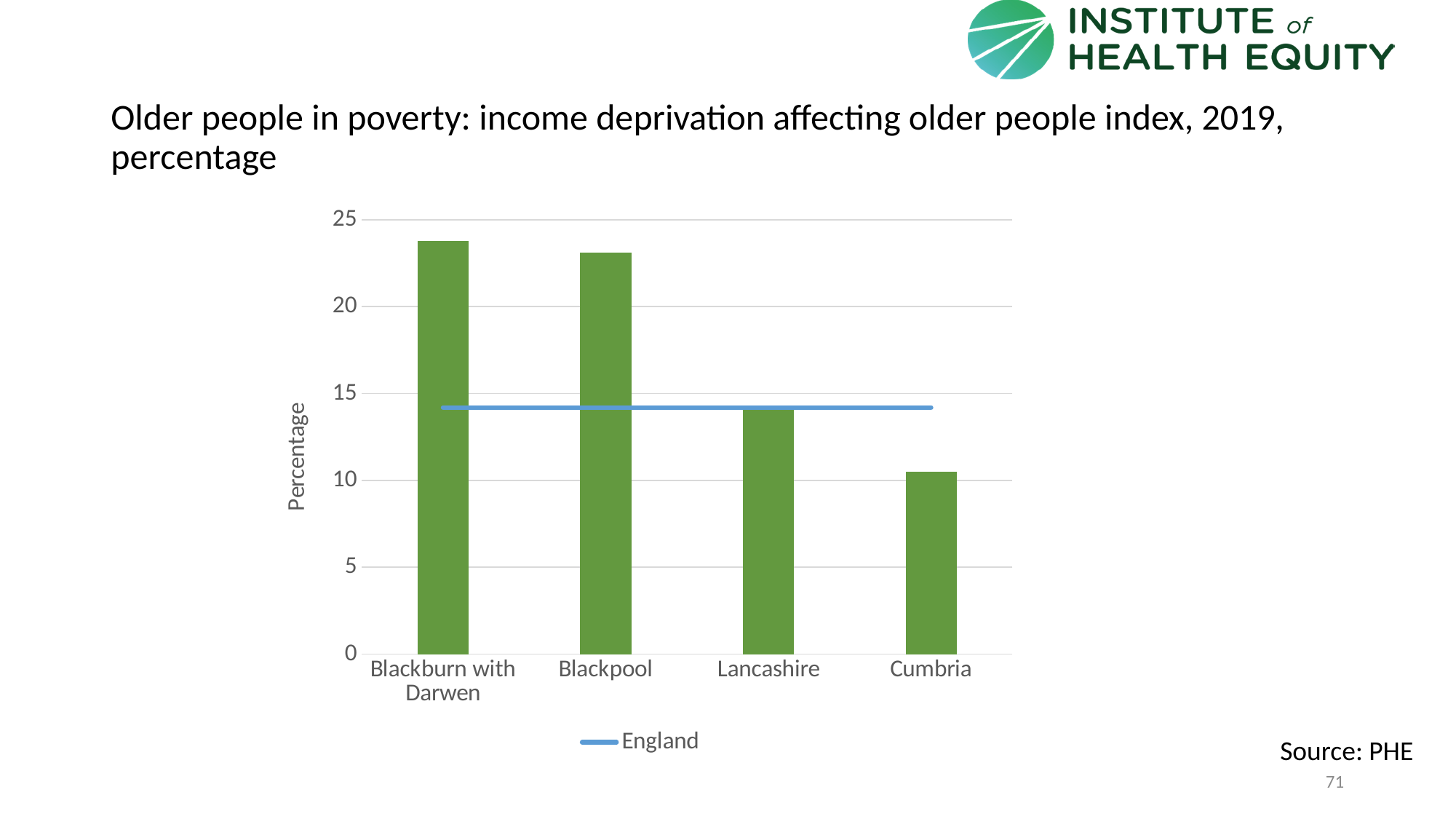
Is the value for Blackburn with Darwen greater or less than 20? greater Is the value for Lancashire greater or less than 15? less What does the horizontal blue line on the chart represent, according to the legend? England Which has the larger value, Blackpool or Lancashire? Blackpool Which area has the highest percentage of older people in poverty? Blackburn with Darwen Is the value for Cumbria greater or less than 15? less What kind of chart is shown on the slide? bar chart Which has the larger value, Lancashire or Cumbria? Lancashire Which area has the lowest percentage of older people in poverty? Cumbria How many areas are plotted as bars on the chart? 4 How many entries does the legend list? 1